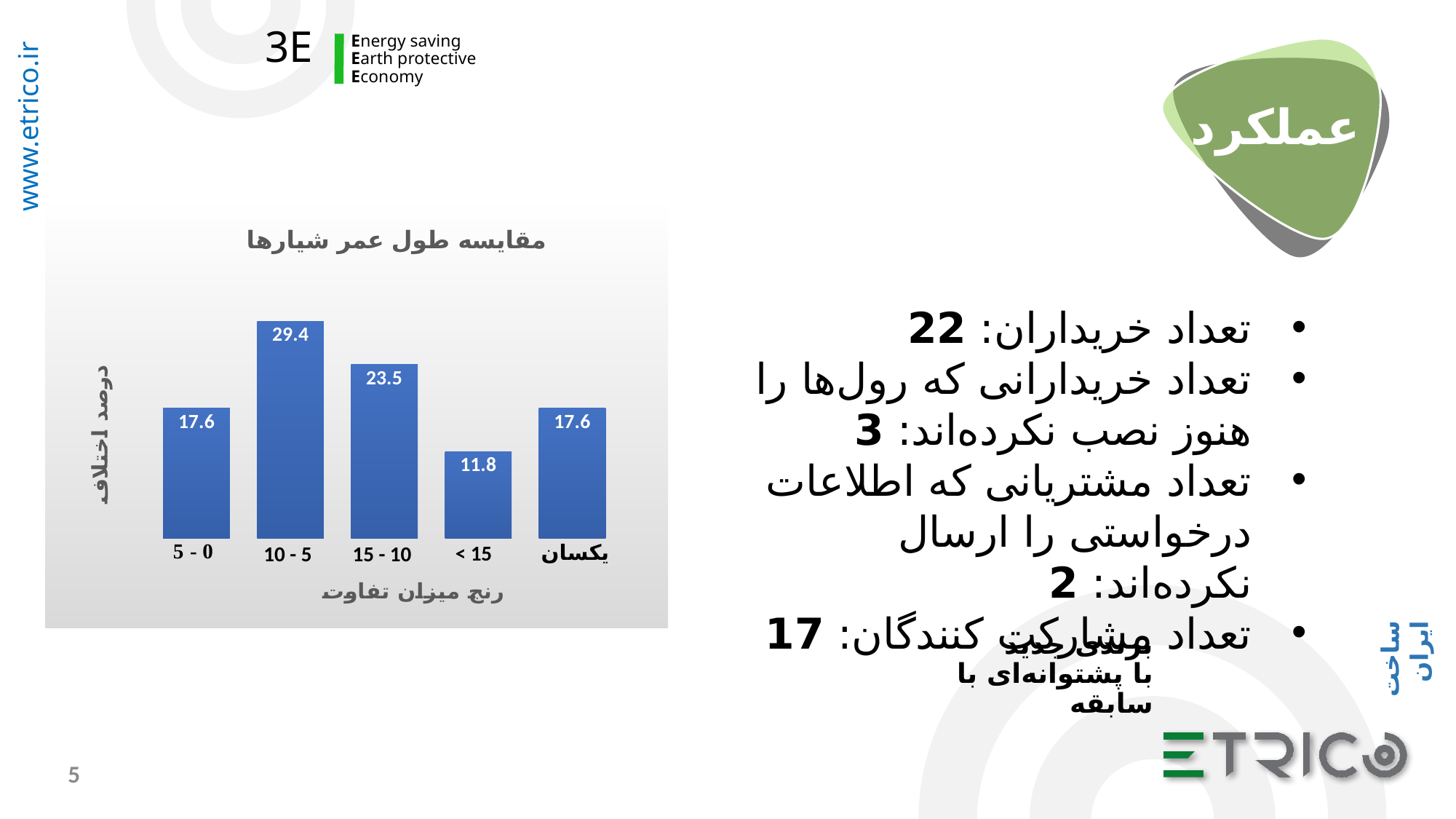
What is the value for the category "15 - 10"? 23.5 What type of chart is shown on the slide? bar chart What is the value for the category "< 15"? 11.8 What is the value for the category "یکسان"? 17.6 Which category has the lowest value? < 15 How many bars (categories) does the chart have? 5 Which category has the highest value? 10 - 5 Which is larger, the value for "15 - 10" or the value for "< 15"? 15 - 10 What is the value for the category "10 - 5"? 29.4 What is the difference between the values for "10 - 5" and "15 - 10"? 5.9 What is the label of the x axis? رنج میزان تفاوت What is the title of the chart? مقایسه طول عمر شیارها